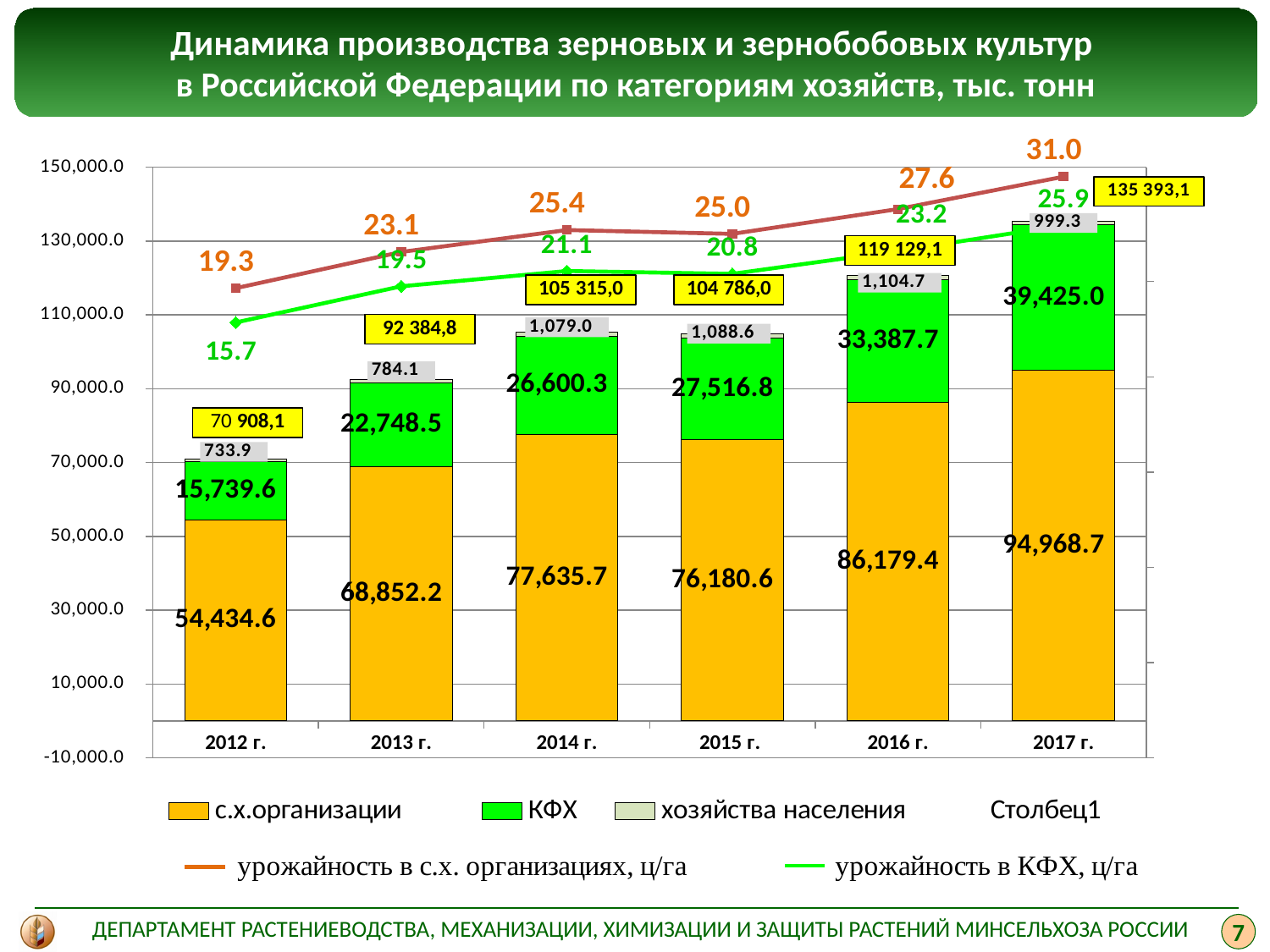
Does урожайность в с.х. организациях, ц/га rise or fall from 2012 г. to 2017 г. overall? rise What is the total of the stacked bar for 2016 г. as labelled on the chart? 119 129,1 What is the value for с.х.организации in 2017 г.? 94,968.7 What is the value of урожайность в с.х. организациях, ц/га in 2012 г.? 19.3 How many years are shown on the x axis? 6 What is the difference between the с.х.организации values in 2017 г. and 2016 г.? 8,789.3 What is the value for хозяйства населения in 2016 г.? 1,104.7 What is the value for КФХ in 2014 г.? 26,600.3 What is the value of урожайность в КФХ, ц/га in 2017 г.? 25.9 Which is larger: the с.х.организации value in 2014 г. or in 2015 г.? 2014 г. In which year is the value for с.х.организации the lowest? 2012 г. In which year is the value for КФХ the highest? 2017 г.